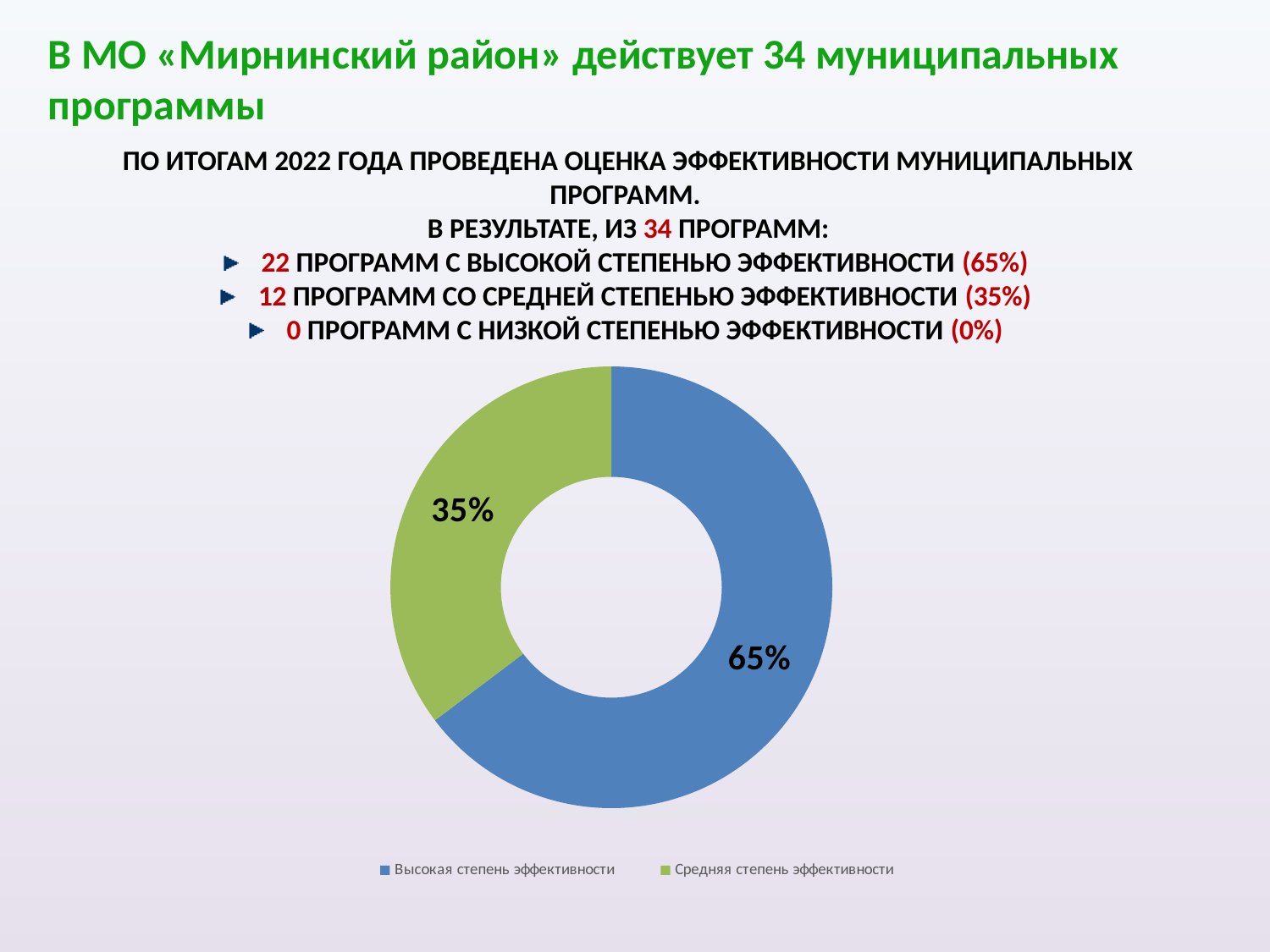
What is the difference in percentage points between the "Высокая степень эффективности" slice and the "Средняя степень эффективности" slice? 30 Which category has the largest slice in the chart? Высокая степень эффективности Which slice is larger: "Высокая степень эффективности" or "Средняя степень эффективности"? Высокая степень эффективности Which category has the smallest slice in the chart? Средняя степень эффективности What share of the doughnut chart is labelled "Высокая степень эффективности"? 65% Is the share for "Высокая степень эффективности" greater or less than 50%? greater What colour is the "Высокая степень эффективности" slice? Blue How many slices does the chart have? 2 What kind of chart is shown on the slide? Doughnut (pie) chart What colour is the "Средняя степень эффективности" slice? Green What share of the doughnut chart is labelled "Средняя степень эффективности"? 35% How many entries does the chart legend list? 2